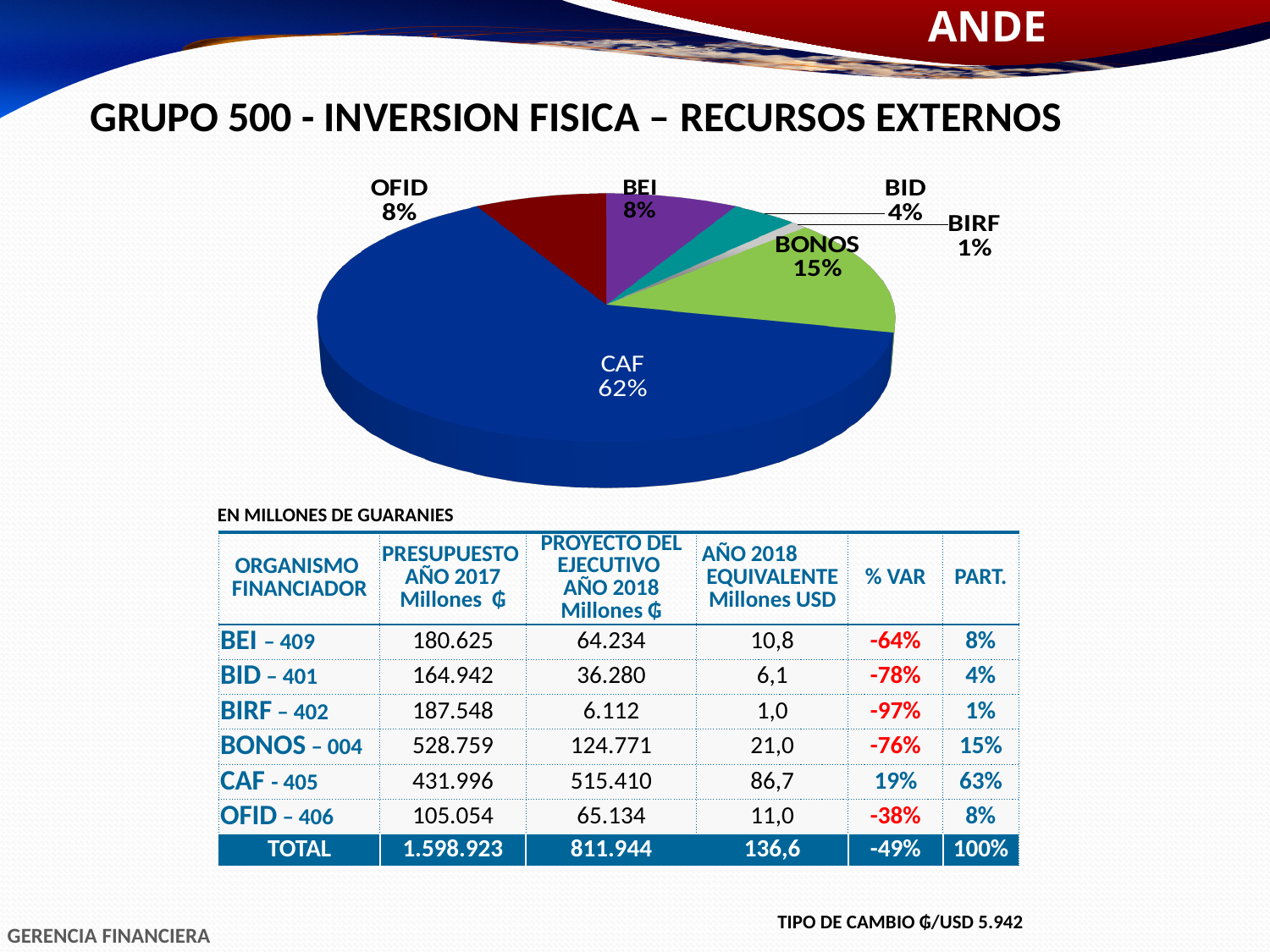
What share of the pie does BONOS represent? 15% What share of the pie does BIRF represent? 1% What is the difference in percentage points between the CAF slice and the BONOS slice? 47 Which category has the largest slice of the pie? CAF How many slices does the pie chart have? 6 Which slice is larger, BONOS or BID? BONOS What kind of chart is shown on the slide? pie chart What share of the pie does CAF represent? 62% What colour is the CAF slice of the pie chart? blue What share of the pie does BID represent? 4% Which category has the smallest slice of the pie? BIRF What is the difference in percentage points between the BID slice and the BIRF slice? 3